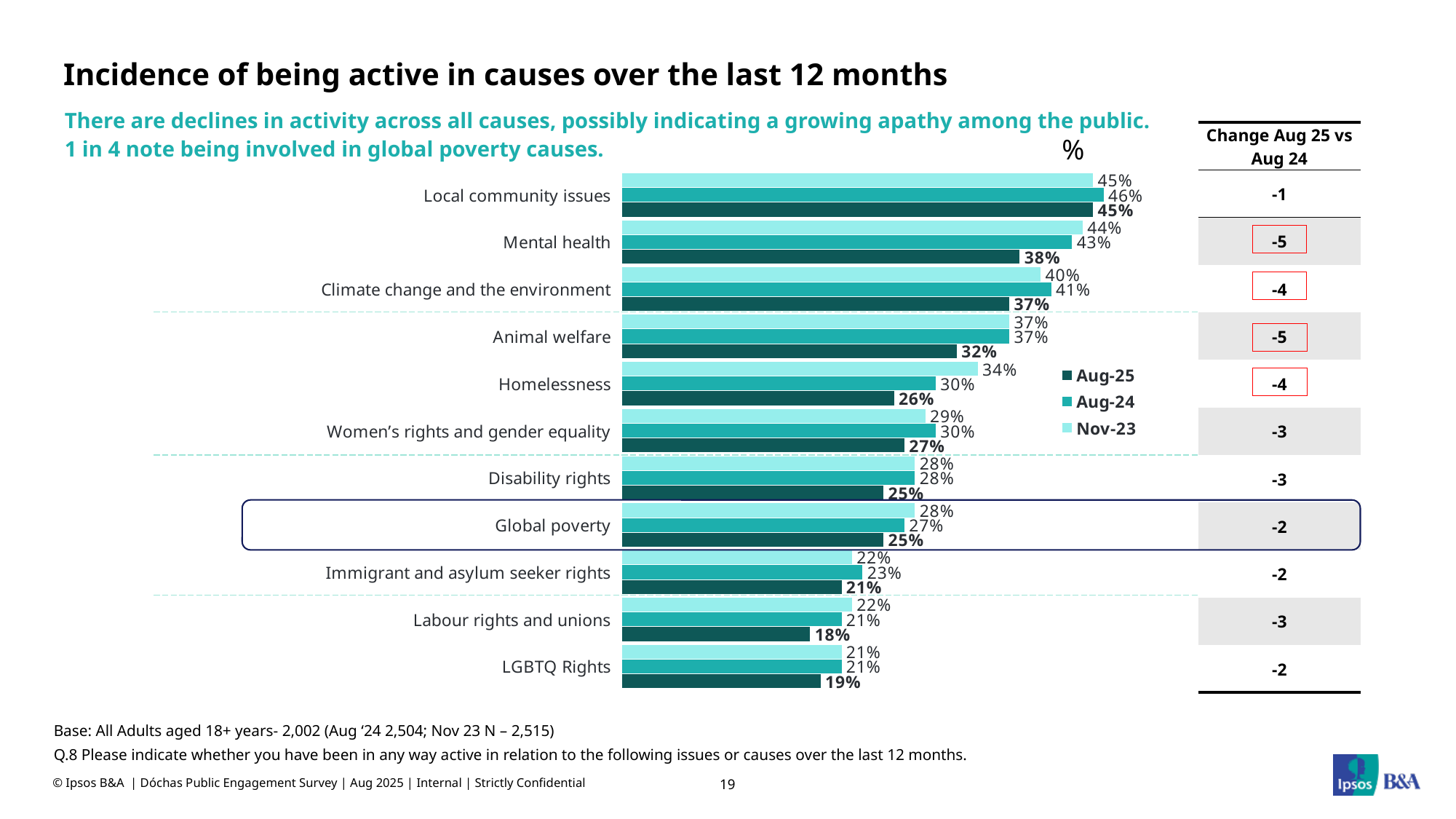
Which is larger for Homelessness: the Nov-23 value or the Aug-25 value? Nov-23 What is the Aug-25 value for Global poverty? 25% How many series does the legend list? 3 What is the difference between the Aug-24 and Aug-25 values for Animal welfare? 5 percentage points What is the Aug-24 value for Homelessness? 30% According to the 'Change Aug 25 vs Aug 24' column, what is the change for Mental health? -5 What kind of chart is shown on the slide? Bar chart What is the Aug-25 value for Mental health? 38% Which cause has the lowest Aug-25 value? Labour rights and unions Which cause has the highest Aug-25 value? Local community issues How many causes are shown on the chart? 11 What is the Nov-23 value for Climate change and the environment? 40%